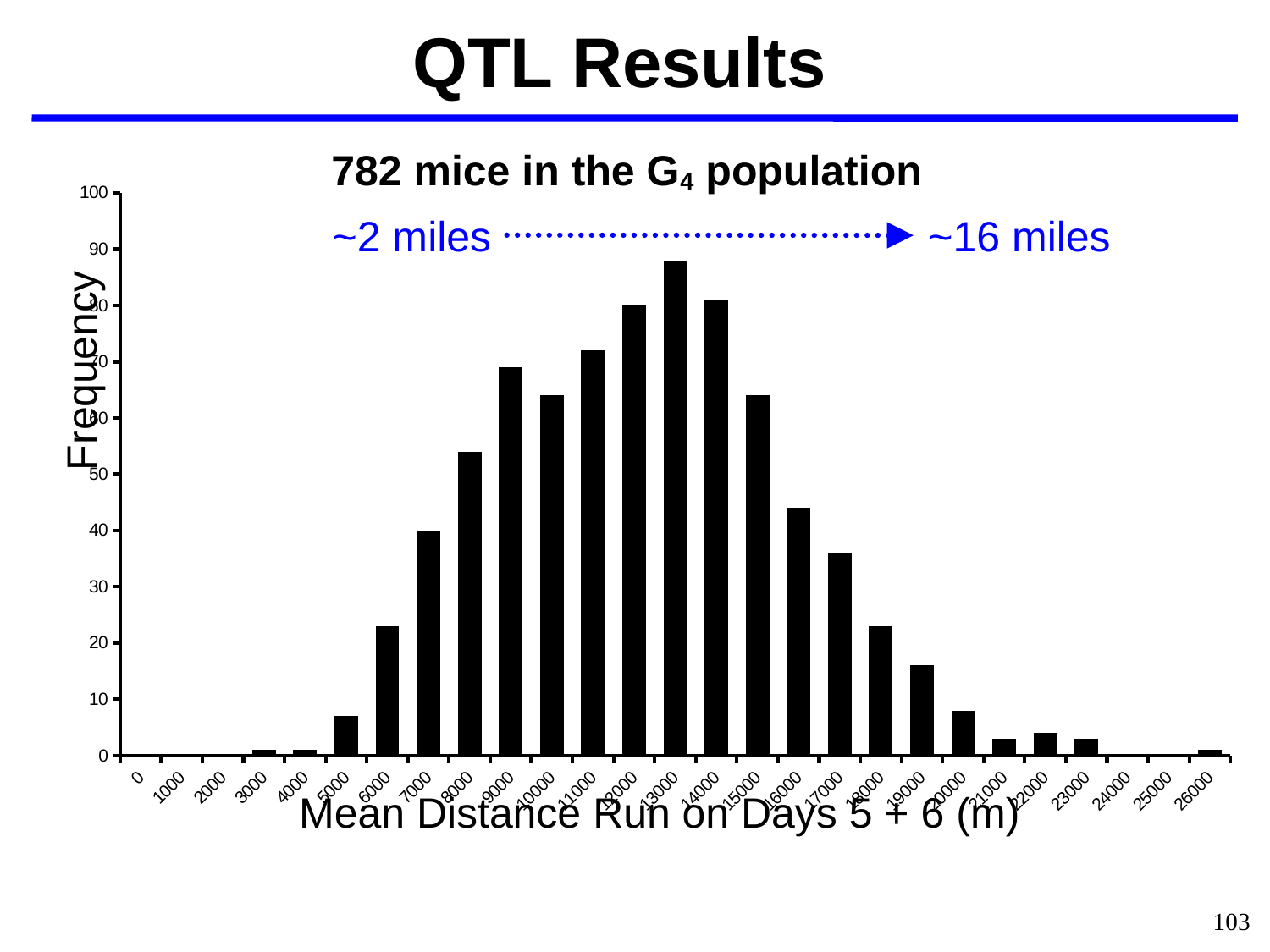
Is the frequency for 19000 greater or less than 20? less Is the frequency for 15000 greater or less than 60? greater Is the frequency for 17000 greater or less than 40? less What kind of chart is shown on the slide? bar chart How many categories are labelled on the x axis? 27 Which has a higher frequency, 9000 or 16000? 9000 Which has a higher frequency, 6000 or 12000? 12000 What is the label of the y axis? Frequency Which x-axis category has the highest frequency? 13000 What is the label of the x axis? Mean Distance Run on Days 5 + 6 (m)